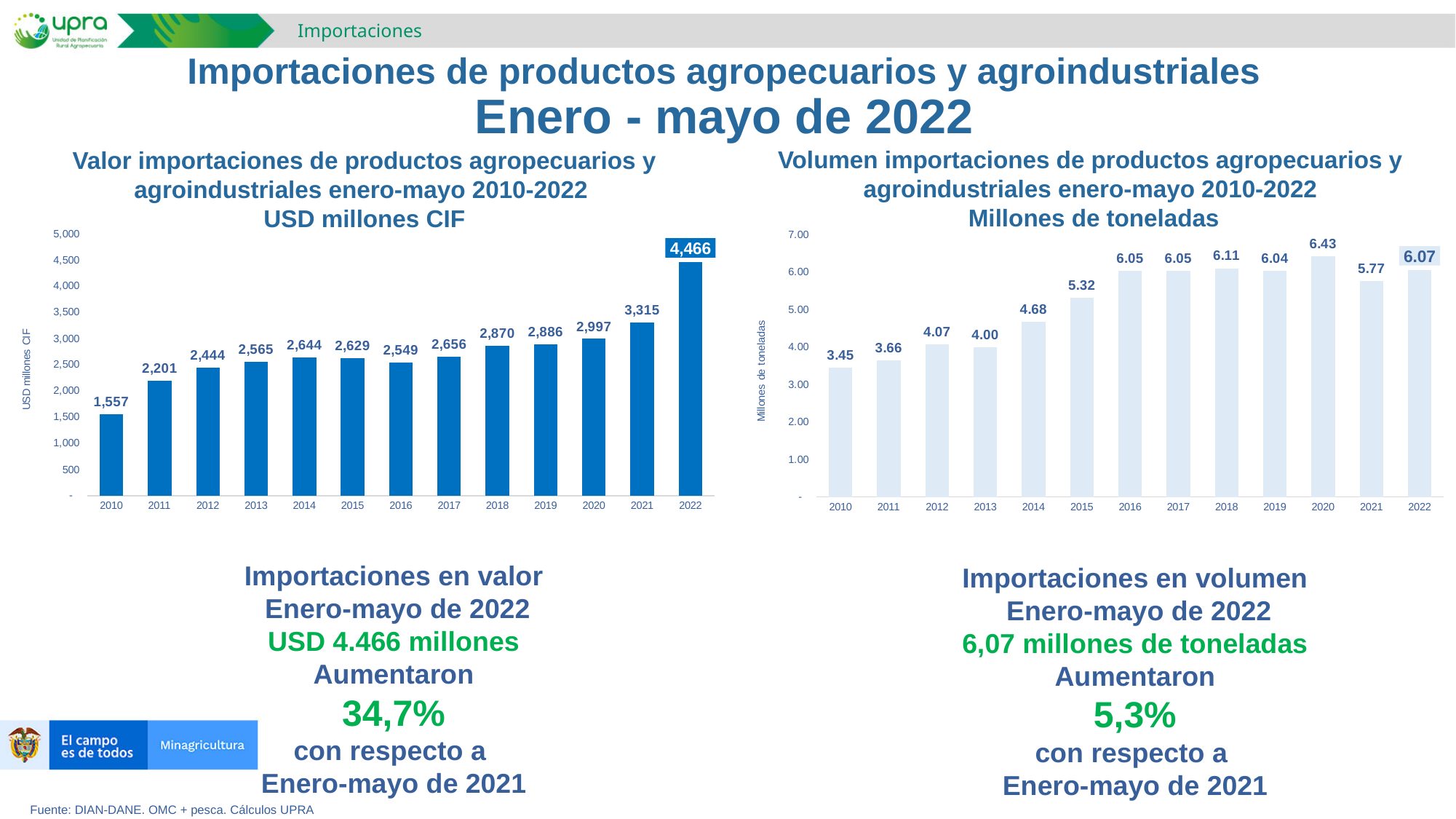
In the left chart (Valor importaciones, USD millones CIF), what is the difference between the 2022 and 2021 values? 1,151 In the left chart (Valor importaciones, USD millones CIF), how many years are plotted? 13 In the left chart (Valor importaciones, USD millones CIF), what is the value for 2022? 4,466 In the left chart (Valor importaciones, USD millones CIF), which is larger, the value for 2014 or the value for 2016? 2014 In the right chart (Volumen importaciones, Millones de toneladas), what is the difference between the 2022 and 2021 values? 0.30 In the right chart (Volumen importaciones, Millones de toneladas), what is the y-axis label? Millones de toneladas In the left chart (Valor importaciones, USD millones CIF), what is the value for 2010? 1,557 In the right chart (Volumen importaciones, Millones de toneladas), which year has the highest value? 2020 In the left chart (Valor importaciones, USD millones CIF), which year has the lowest value? 2010 In the right chart (Volumen importaciones, Millones de toneladas), is the value for 2015 greater or less than 5.00? greater In the right chart (Volumen importaciones, Millones de toneladas), what is the value for 2020? 6.43 What type of chart is the left chart (Valor importaciones, USD millones CIF)? Bar chart